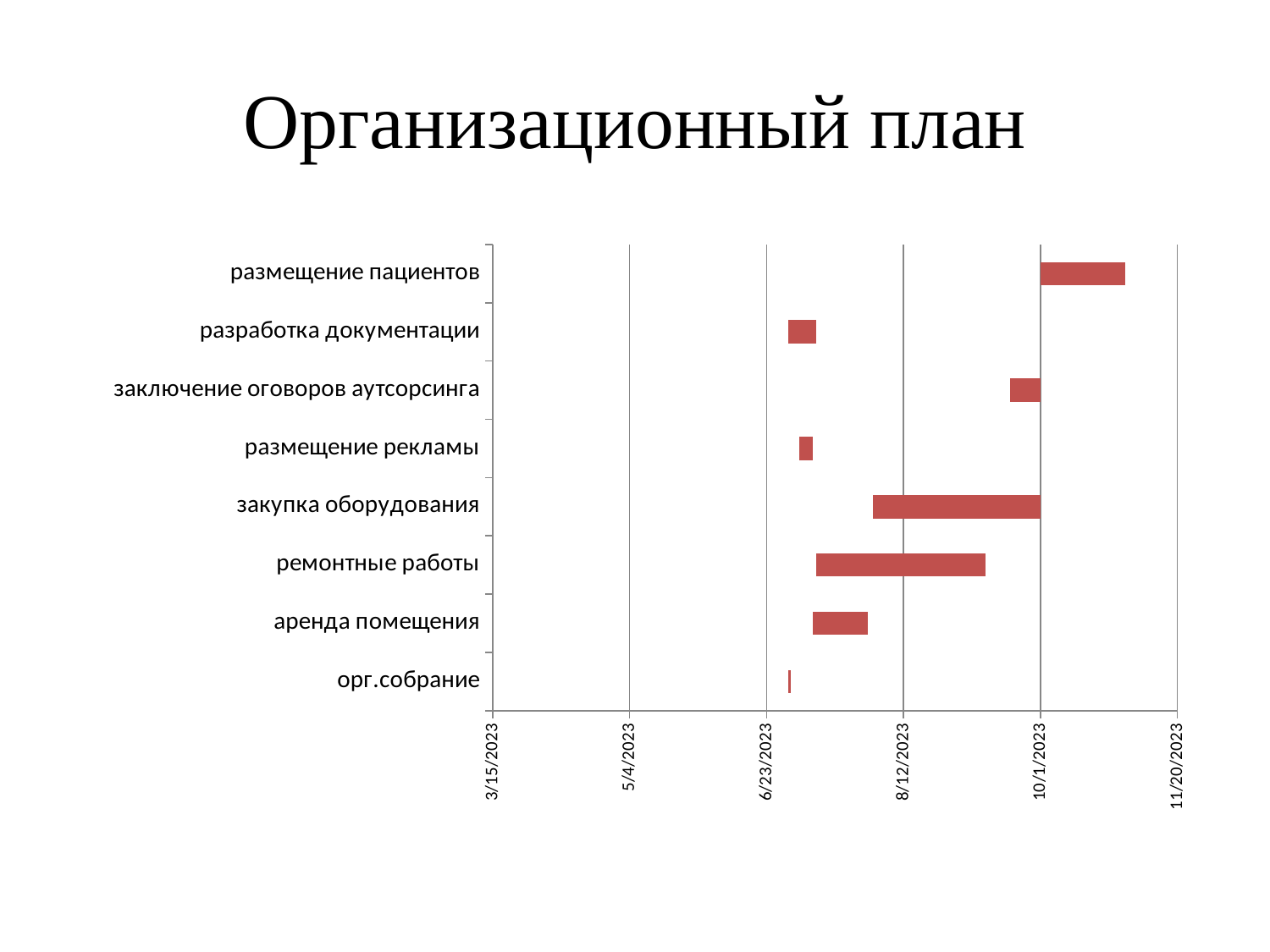
What is the earliest date label shown on the horizontal axis? 3/15/2023 Does the bar for разработка документации lie before or after 8/12/2023? before Which bar is longer: ремонтные работы or аренда помещения? ремонтные работы Which task's bar starts latest on the date axis? размещение пациентов What is the title of the slide containing the chart? Организационный план How many tasks (categories) are listed on the vertical axis of the chart? 8 Does the bar for ремонтные работы extend past 8/12/2023? yes Which task has the shortest bar in the chart? орг.собрание What kind of chart is shown on the slide? bar chart